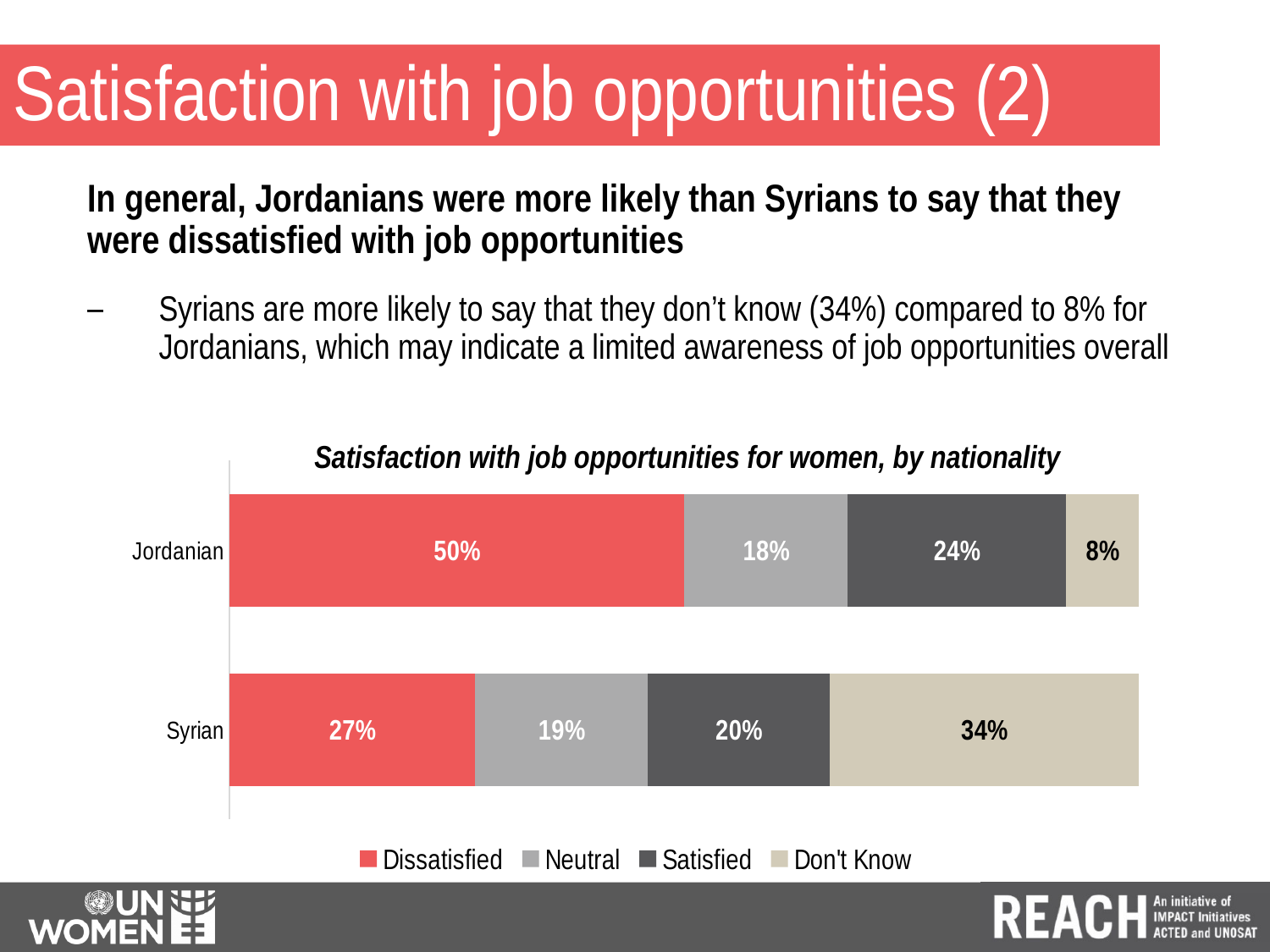
What is the difference between the 'Don't Know' shares of Syrians and Jordanians? 26% How many series does the legend list? 4 What percentage of Jordanians were dissatisfied with job opportunities for women? 50% What is the difference between the Dissatisfied shares of Jordanians and Syrians? 23% Which response category is the smallest for Jordanians? Don't Know What percentage of Syrians answered 'Don't Know' about satisfaction with job opportunities for women? 34% What type of chart is shown on the slide? Stacked bar chart Which response category is the largest for Syrians? Don't Know What is the Satisfied share for Jordanians? 24% Which nationality has the higher Dissatisfied share? Jordanian What is the title of the chart? Satisfaction with job opportunities for women, by nationality What is the Neutral share for Syrians? 19%